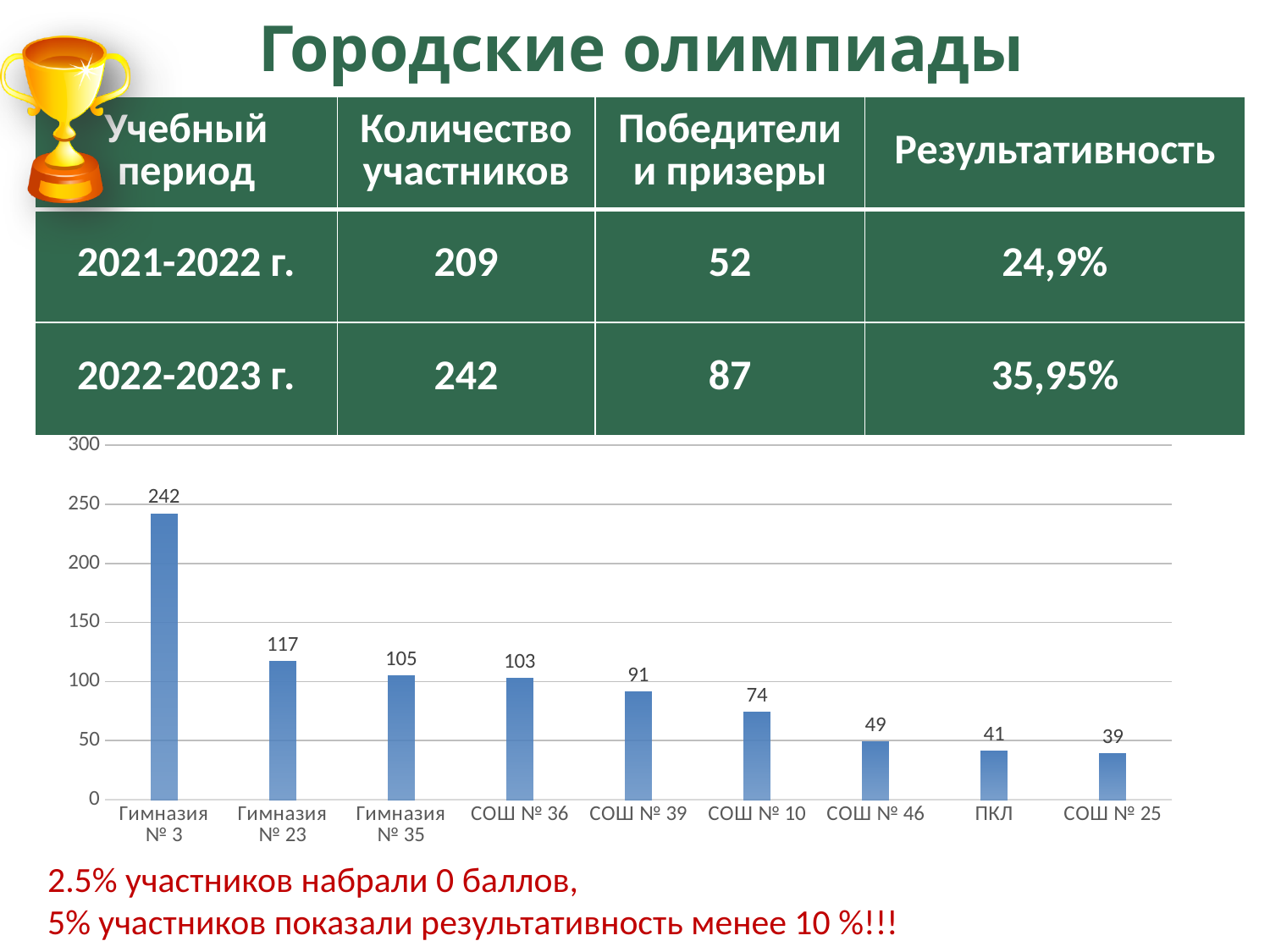
What is the value for Гимназия № 3 in the bar chart? 242 How many categories are shown on the x axis of the bar chart? 9 What is the difference between the values for СОШ № 10 and СОШ № 46 in the bar chart? 25 Is the value for СОШ № 36 in the bar chart greater or less than 100? greater What is the difference between the values for Гимназия № 3 and Гимназия № 23 in the bar chart? 125 Do the values in the bar chart rise or fall from left to right along the x axis? fall What kind of chart is shown on the slide? bar chart What is the value for СОШ № 39 in the bar chart? 91 Which category has the highest value in the bar chart? Гимназия № 3 Which is larger in the bar chart, the value for Гимназия № 35 or the value for СОШ № 39? Гимназия № 35 Which category has the lowest value in the bar chart? СОШ № 25 What is the value for ПКЛ in the bar chart? 41